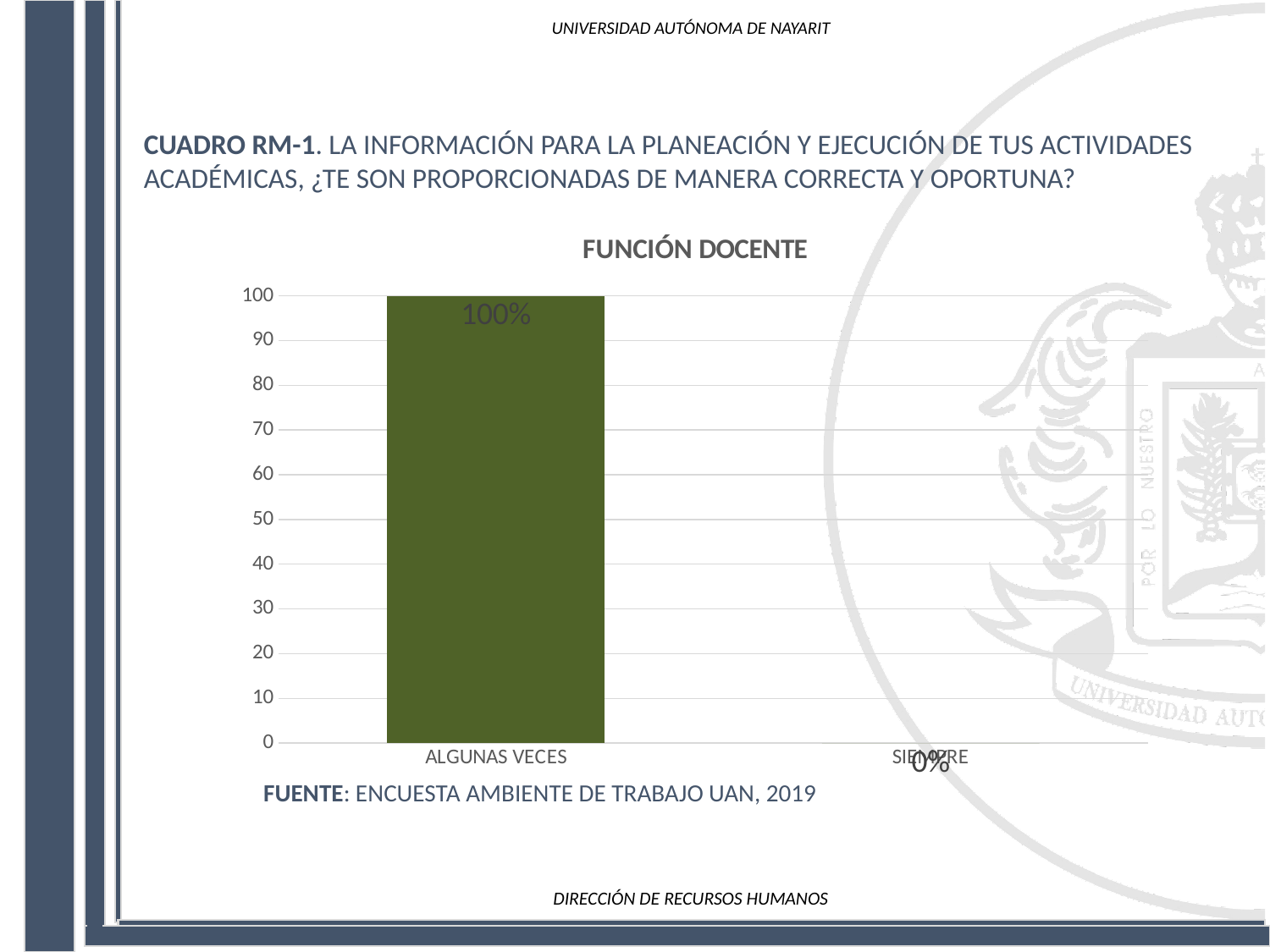
What kind of chart is shown on the slide? bar chart What is the value for SIEMPRE? 0% Is the value for ALGUNAS VECES greater or less than 50? greater What is the difference between the values for ALGUNAS VECES and SIEMPRE? 100% Which category has the highest value? ALGUNAS VECES What is the title of the chart? FUNCIÓN DOCENTE How many categories are shown on the x axis? 2 What is the maximum value shown on the y axis? 100 Which category has the lowest value? SIEMPRE What is the value for ALGUNAS VECES? 100% Which is larger, the value for ALGUNAS VECES or the value for SIEMPRE? ALGUNAS VECES